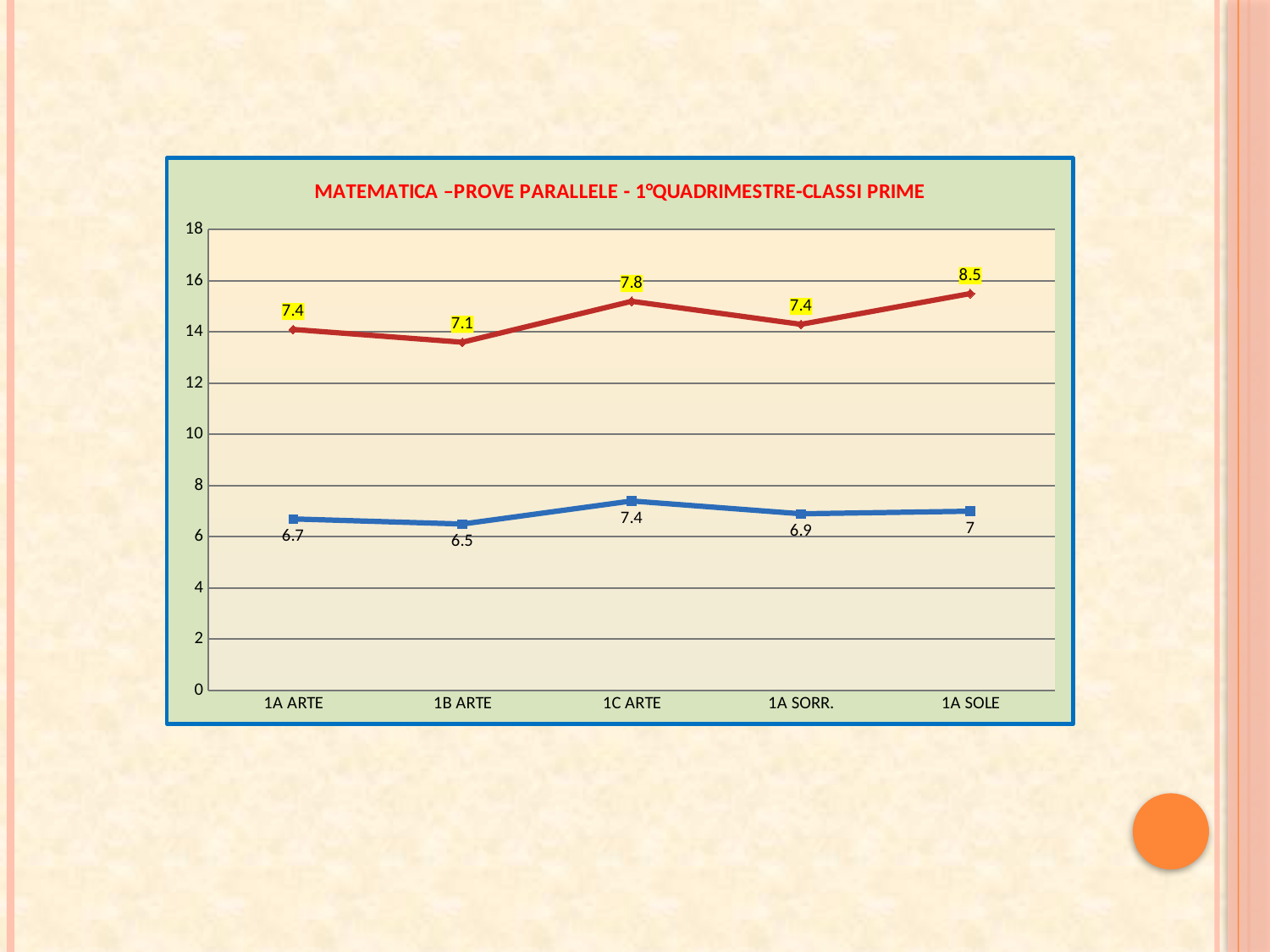
What is the difference between the red line's data labels for 1A SOLE and 1A ARTE? 1.1 What is the data label on the red line for 1A SOLE? 8.5 What is the title of the chart? MATEMATICA –PROVE PARALLELE - 1°QUADRIMESTRE-CLASSI PRIME What kind of chart is shown on the slide? line chart What is the data label on the blue line for 1B ARTE? 6.5 Does the blue line rise or fall from 1A ARTE to 1B ARTE? fall What is the data label on the red line for 1C ARTE? 7.8 How many categories are shown on the x axis? 5 Which category has the highest data label on the red line? 1A SOLE Which category has the lowest data label on the blue line? 1B ARTE For 1C ARTE, which line has the larger data label, the red line or the blue line? red line What is the data label on the blue line for 1A SORR.? 6.9